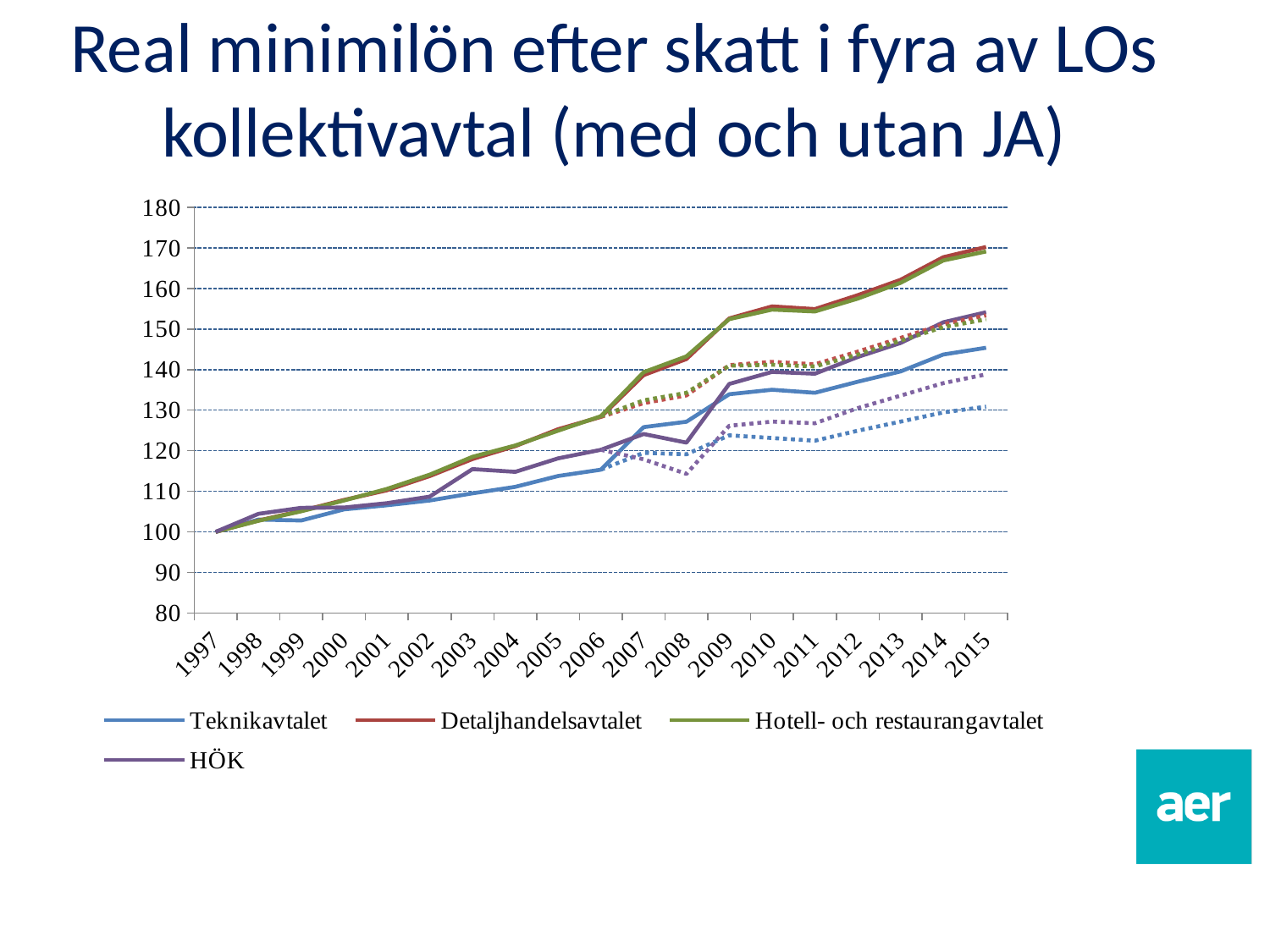
Do the solid lines generally rise or fall from 1997 to 2015? rise In 2015, which solid line is higher: Teknikavtalet or HÖK? HÖK Which colour is used for the Teknikavtalet series in the legend? blue Is the value of the solid Teknikavtalet line in 2015 greater or less than 140? greater Is the value of the solid HÖK line in 2003 greater or less than 110? greater Is the value of the solid Detaljhandelsavtalet line in 2015 greater or less than 160? greater What is the value of Teknikavtalet in 1997? 100 How many series does the legend list? 4 What kind of chart is shown on the slide? line chart In 2015, which solid line is higher: Detaljhandelsavtalet or Teknikavtalet? Detaljhandelsavtalet How many years are shown along the x axis? 19